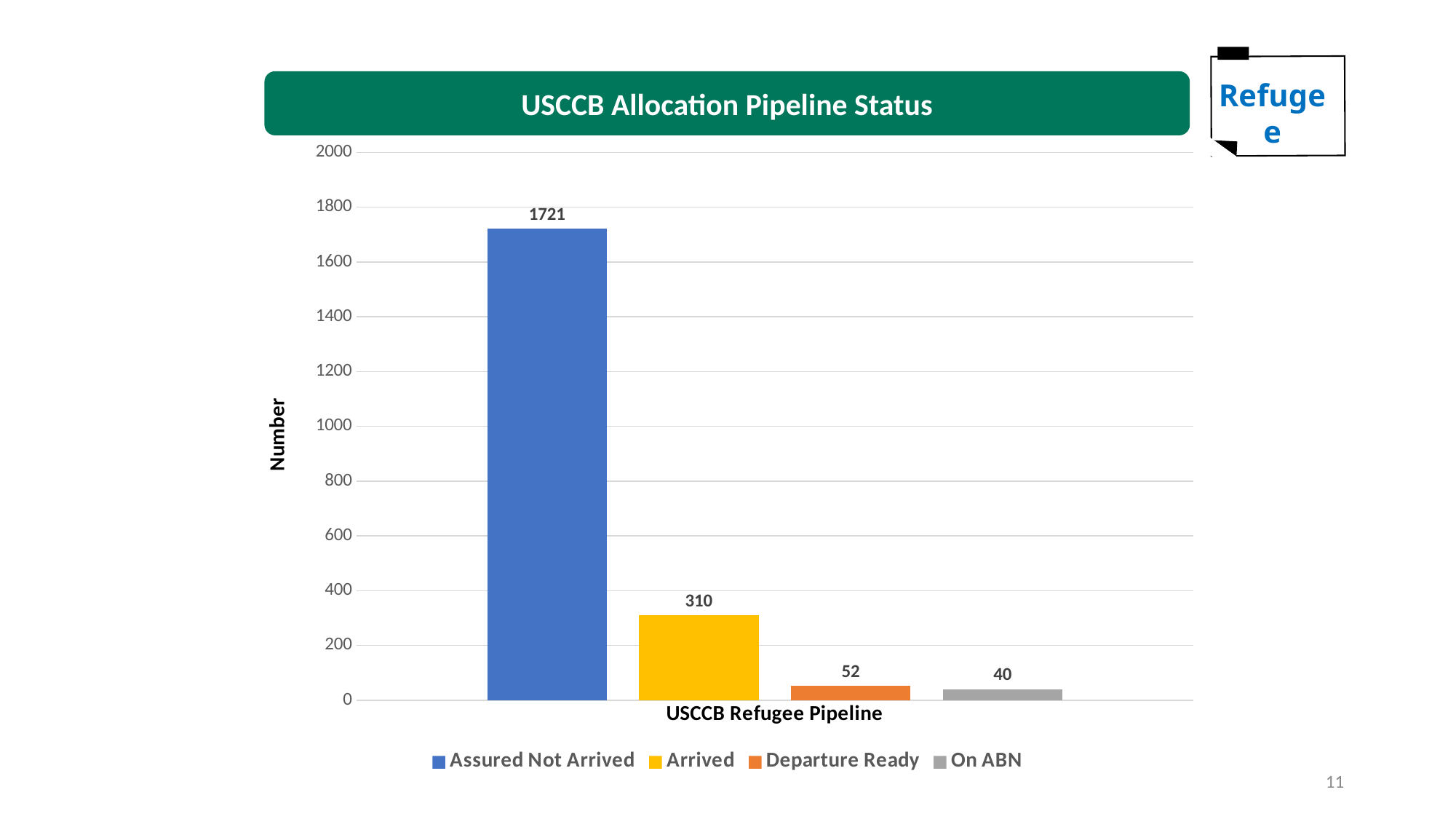
How many series does the legend list? 4 What is the difference between the Assured Not Arrived and Arrived values? 1411 Which series has the lowest value? On ABN What is the value for Arrived? 310 What kind of chart is shown? Bar chart What is the difference between the Departure Ready and On ABN values? 12 What is the title of the chart? USCCB Allocation Pipeline Status What is the value for Departure Ready? 52 Which is larger, Arrived or Departure Ready? Arrived What is the value for On ABN? 40 What is the value for Assured Not Arrived? 1721 Which series has the highest value? Assured Not Arrived